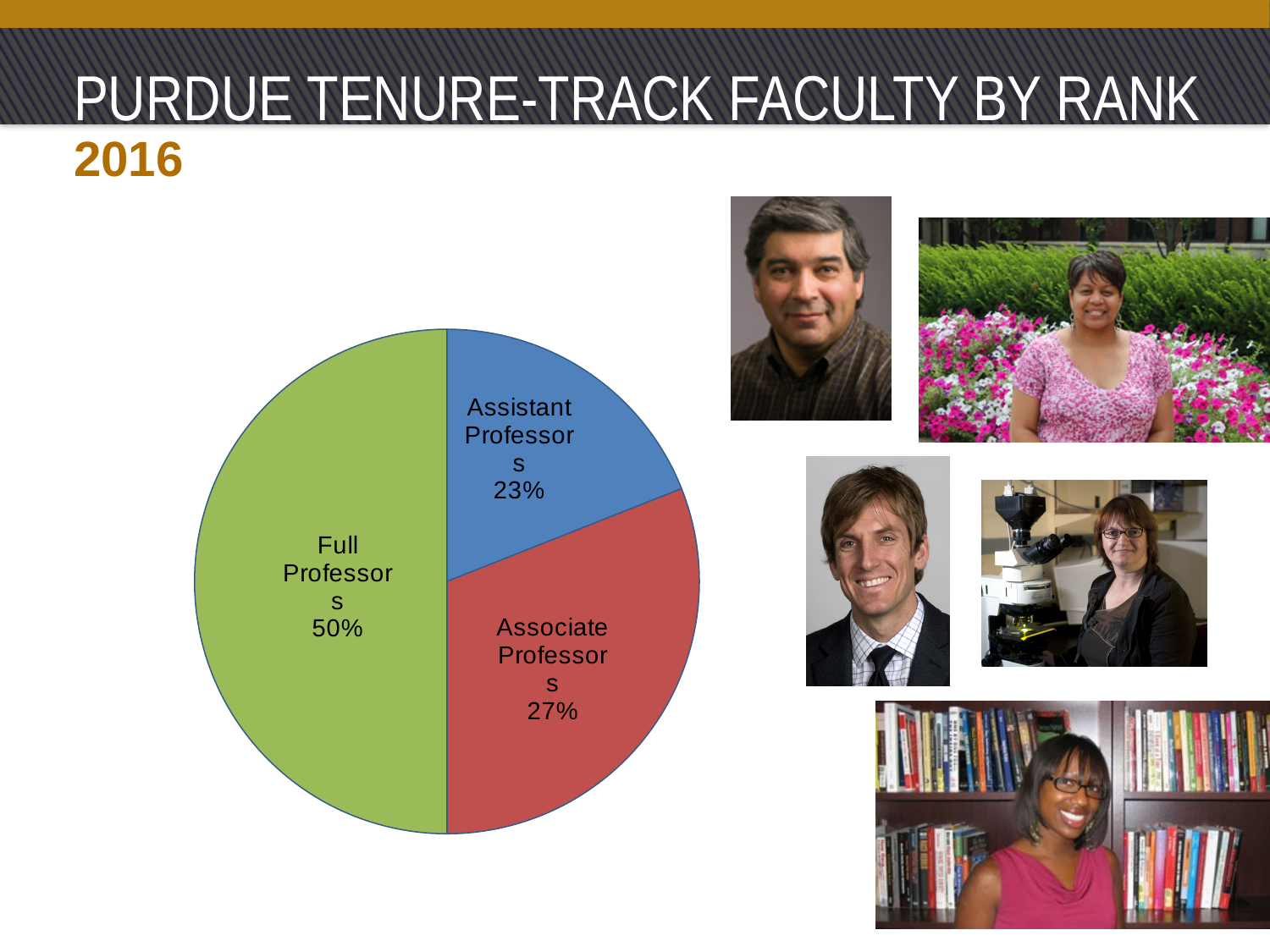
Which rank has the smallest share of the pie? Assistant Professors What share of the pie is Associate Professors? 27% What year does the slide's chart refer to? 2016 Which rank has the largest share of the pie? Full Professors What colour is the Full Professors slice? Green What share of the pie is Full Professors? 50% What share of the pie is Assistant Professors? 23% How many slices does the pie chart have? 3 What is the difference in percentage points between Full Professors and Associate Professors? 23 Which is larger, the share for Associate Professors or Assistant Professors? Associate Professors What kind of chart is shown on the slide? Pie chart What is the difference in percentage points between Associate Professors and Assistant Professors? 4